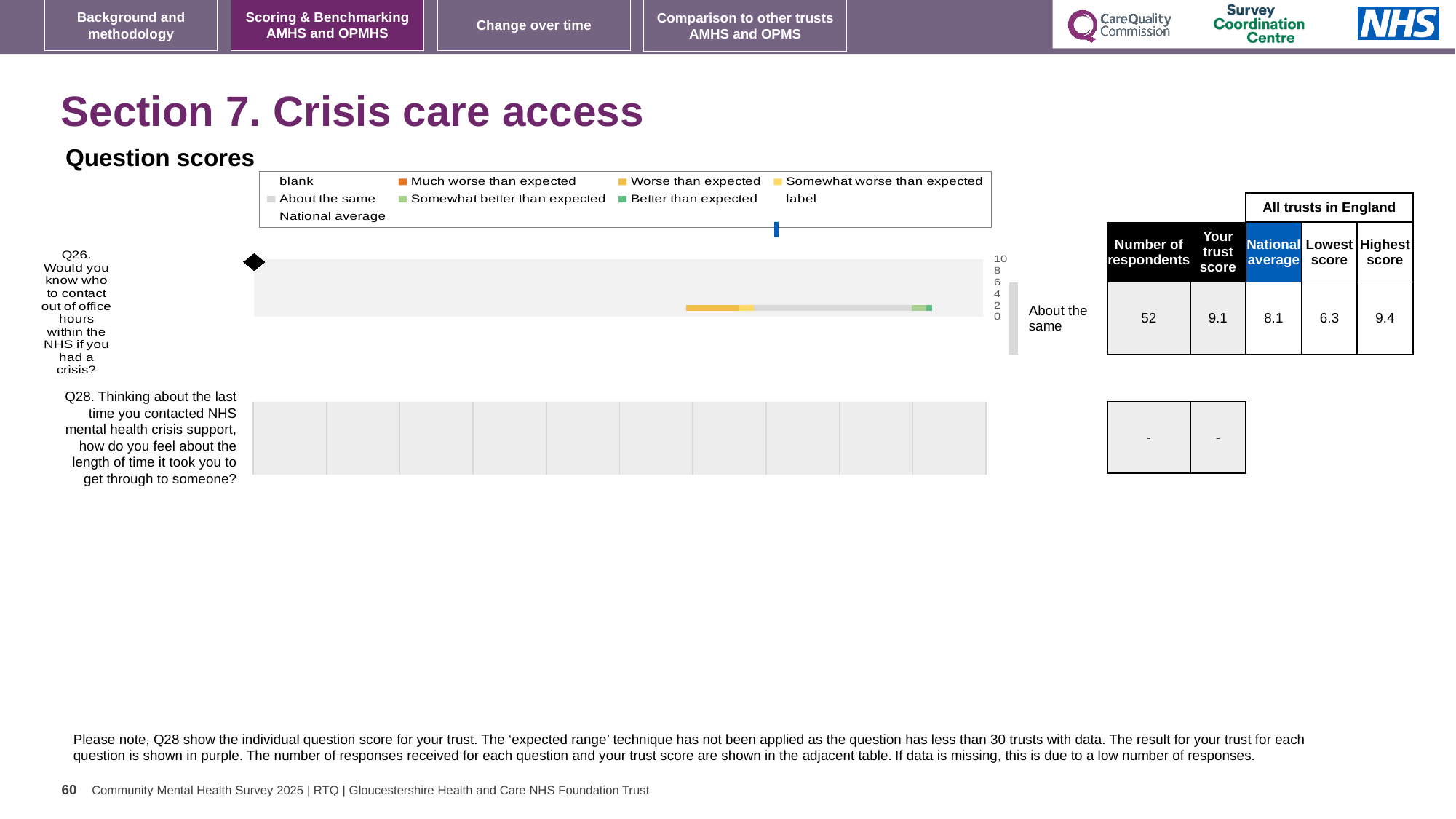
How many questions are plotted in the question scores chart? 2 What is the trust score for Q26 shown beside the question scores chart? 9.1 What is the difference between the highest and lowest scores across all trusts in England for Q26? 3.1 What is the lowest score across all trusts in England for Q26? 6.3 What is the highest score across all trusts in England for Q26? 9.4 What kind of chart is used to show the question scores on this slide? bar chart Is the trust score for Q26 higher or lower than the national average? higher How many respondents answered Q26? 52 Which category label is shown next to the Q26 bar in the question scores chart? About the same Which legend entry in the question scores chart is shown in orange? Much worse than expected What is the national average for Q26 shown beside the question scores chart? 8.1 What is the difference between the trust score and the national average for Q26? 1.0